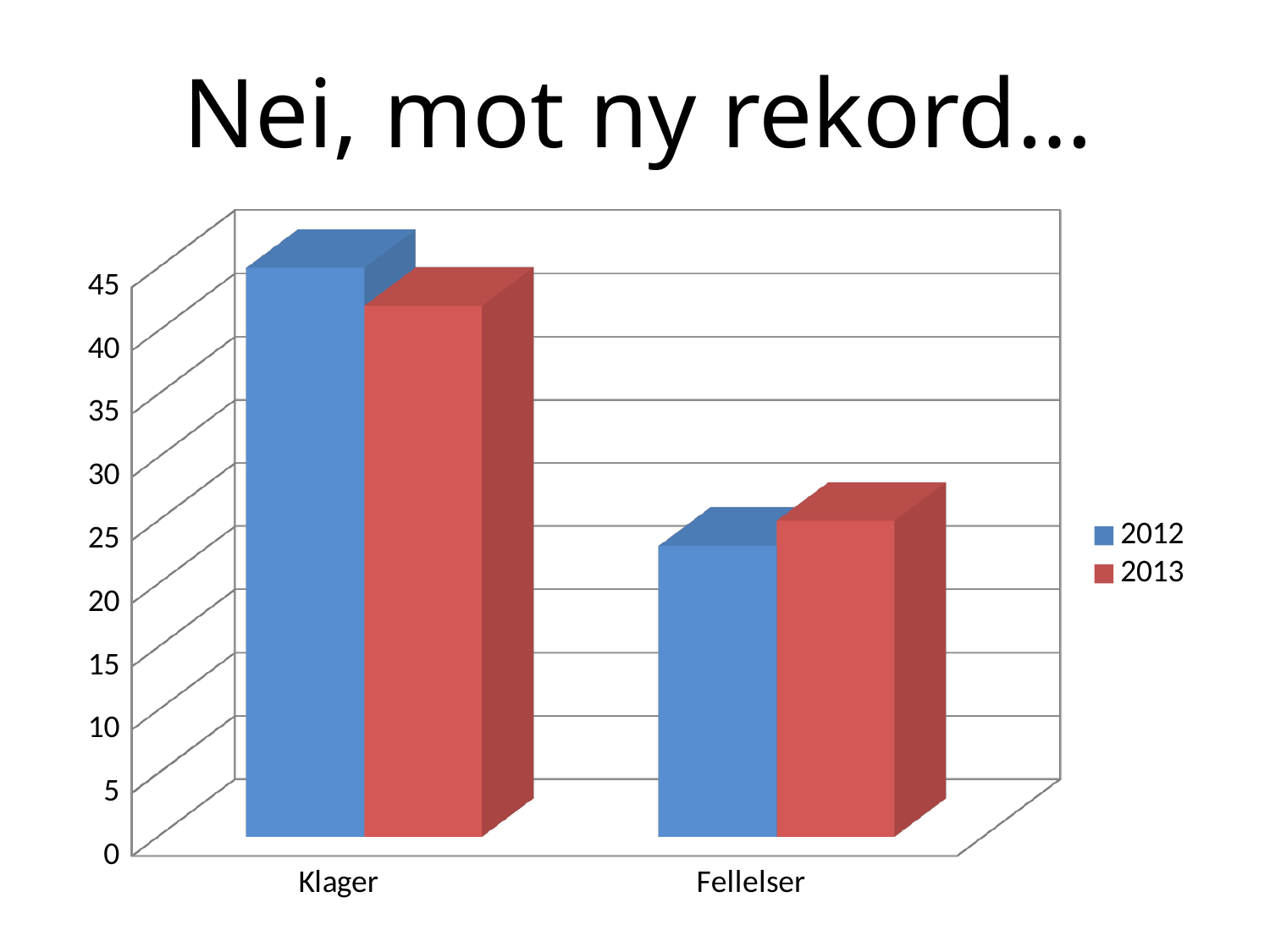
Is the value for Klager in 2012 greater or less than 40? greater What kind of chart is shown on the slide? bar chart How many categories are shown on the x axis of the chart? 2 For Fellelser, which series is larger, 2012 or 2013? 2013 Which category has the lowest value for 2013? Fellelser Is the value for Fellelser in 2013 greater or less than 20? greater Is the value for Fellelser in 2012 greater or less than 30? less For Klager, which series is larger, 2012 or 2013? 2012 Which category has the higher value for 2012, Klager or Fellelser? Klager What is the title of the slide containing the chart? Nei, mot ny rekord… How many series does the chart legend list? 2